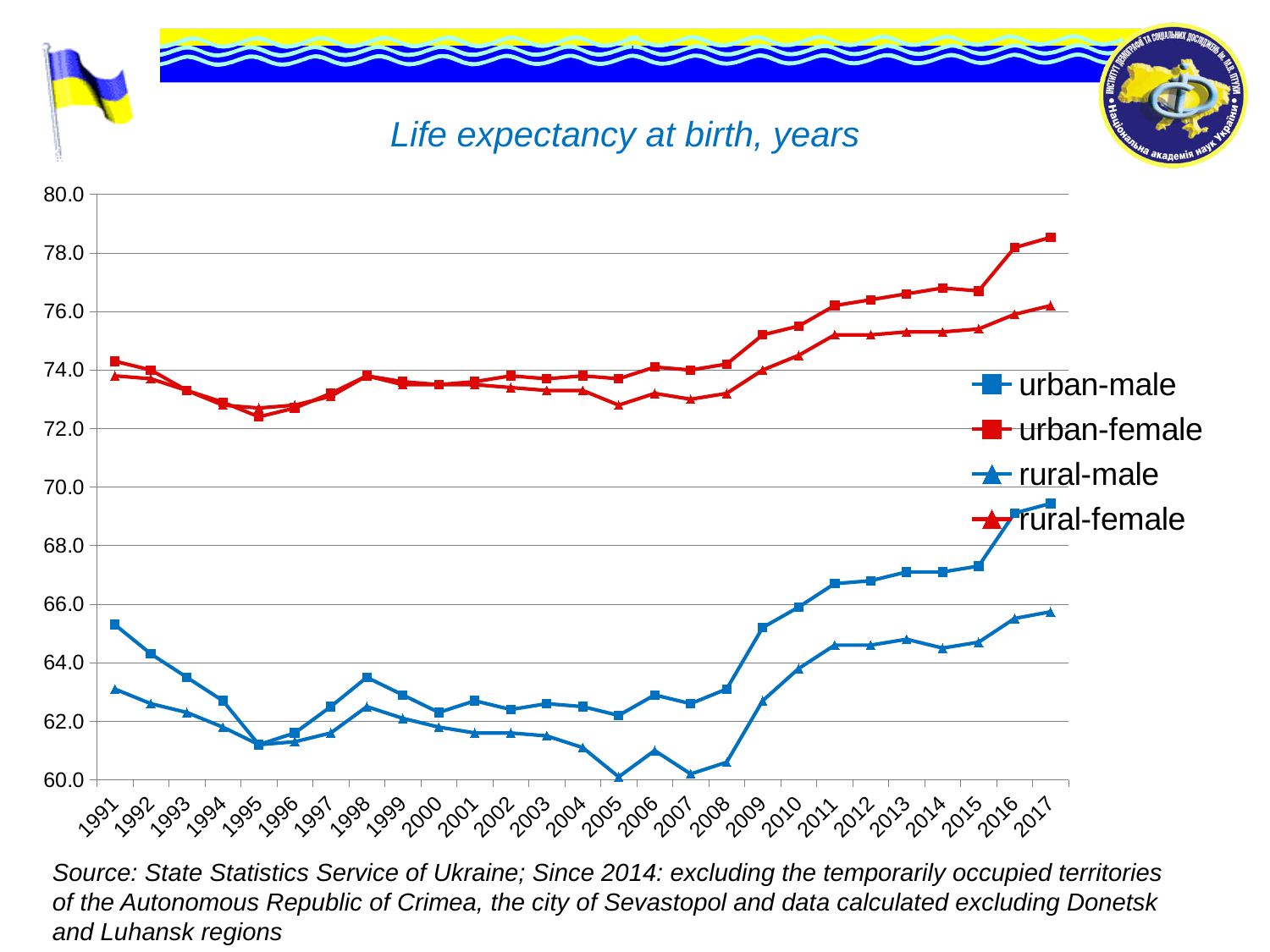
How many years are shown along the x axis? 27 Does the urban-female series rise or fall from 2008 to 2017? rise Is the value for rural-male in 2005 greater or less than 62.0? less Which series has the highest value in 2017? urban-female Which series is plotted with blue triangle markers? rural-male What kind of chart is shown on the slide? line chart In 2017, which is higher: urban-male or rural-male? urban-male How many series does the legend list? 4 In which year is the rural-male series at its lowest? 2005 What is the title of the chart? Life expectancy at birth, years Is the value for urban-male in 2017 greater or less than 70.0? less Is the value for urban-female in 2017 greater or less than 78.0? greater